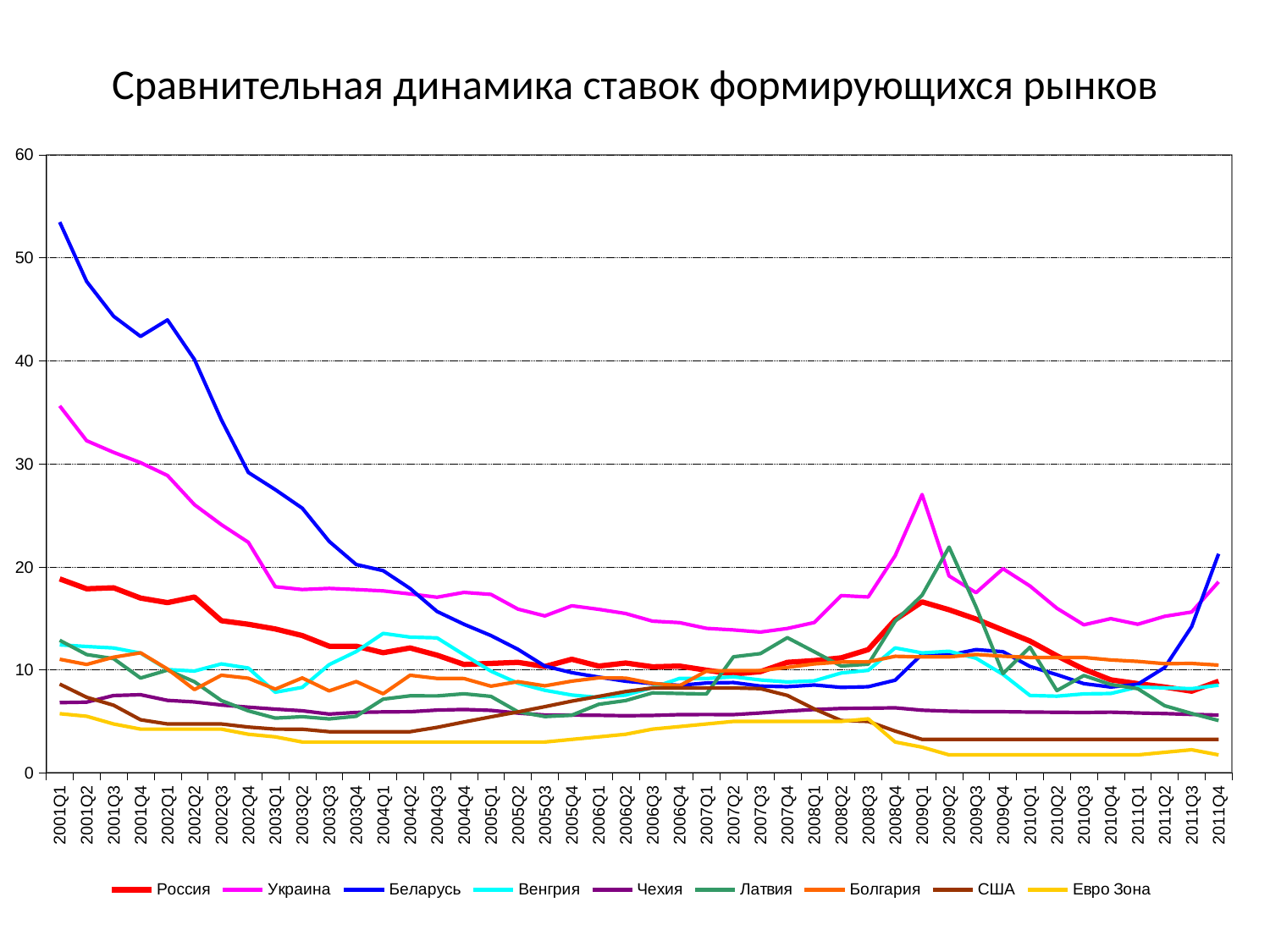
Is the value for Евро Зона at 2011Q4 greater or less than 10? less Is the value for Украина at 2009Q1 greater or less than 20? greater Which series has the highest value at 2009Q2? Латвия Does the Беларусь line rise or fall from 2001Q1 to 2005Q4? falls What is the title of the chart? Сравнительная динамика ставок формирующихся рынков What kind of chart is shown on the slide? line chart Which series has the highest value at 2001Q1? Беларусь How many quarters are plotted along the x axis? 44 How many series does the legend list? 9 Is the value for Беларусь at 2001Q1 greater or less than 50? greater Which is larger at 2001Q1, the value for Беларусь or the value for Украина? Беларусь Which series has the lowest value at 2001Q1? Евро Зона